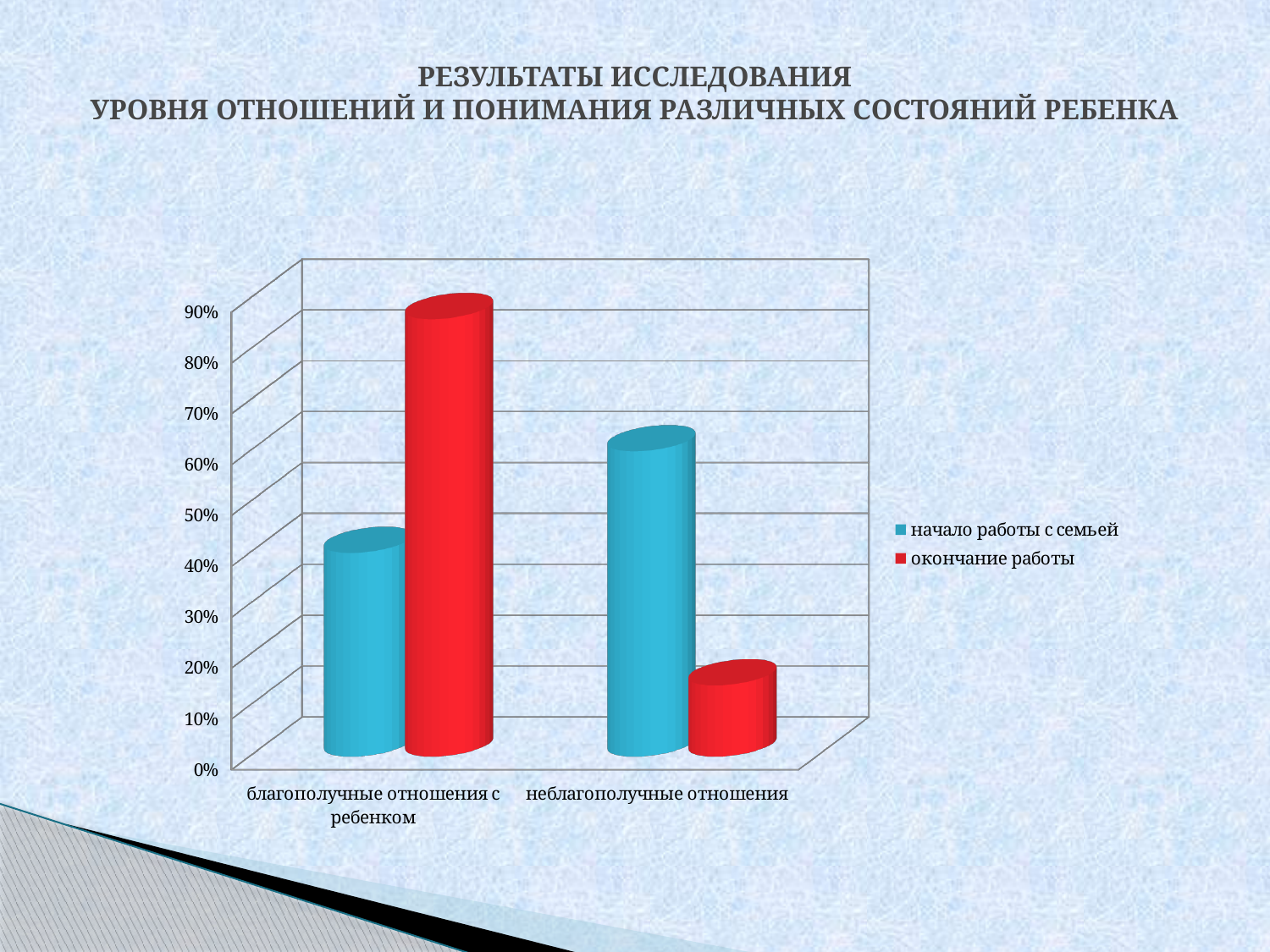
Which series is shown in blue in the chart? начало работы с семьей Is the value for 'окончание работы' in the category 'благополучные отношения с ребенком' greater or less than 80%? greater Is the value for 'начало работы с семьей' in the category 'неблагополучные отношения' greater or less than 50%? greater In the category 'неблагополучные отношения', which series has the larger value: 'начало работы с семьей' or 'окончание работы'? начало работы с семьей How many series does the chart legend list? 2 How many categories are shown on the x axis of the chart? 2 Is the value for 'начало работы с семьей' in the category 'благополучные отношения с ребенком' greater or less than 50%? less In the category 'благополучные отношения с ребенком', which series has the larger value: 'начало работы с семьей' or 'окончание работы'? окончание работы Which series is shown in red in the chart? окончание работы What kind of chart is shown on the slide? bar chart Which bar in the chart is the tallest? окончание работы for благополучные отношения с ребенком